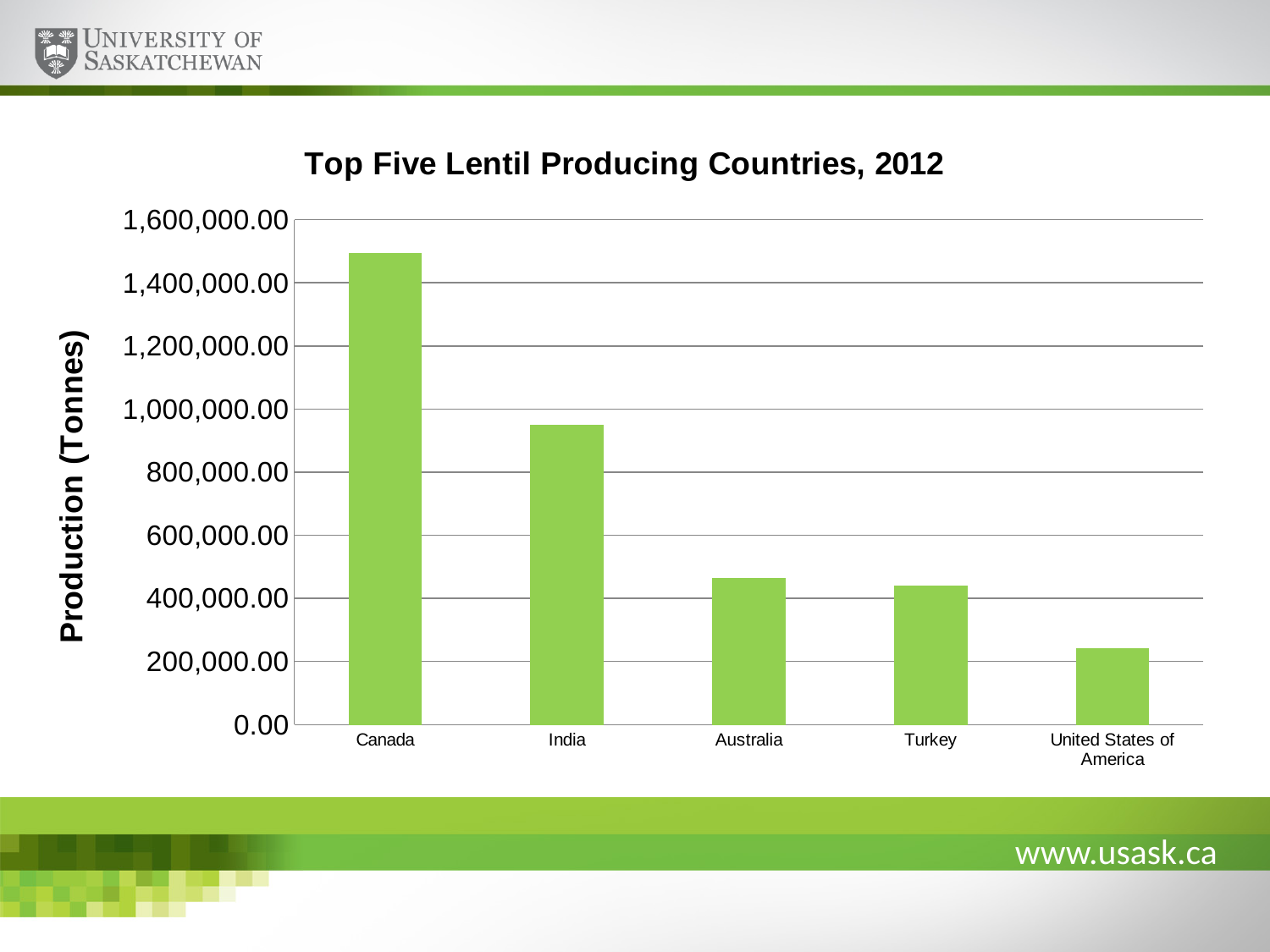
Is the value for United States of America greater or less than 400,000.00? less Is the value for India greater or less than 1,000,000.00? less How many countries are shown in the chart? 5 Which country has the lowest lentil production in the chart? United States of America Which country has the highest lentil production in the chart? Canada Is the value for Canada greater or less than 1,400,000.00? greater What kind of chart is shown on the slide? bar chart Which has the larger value, Turkey or United States of America? Turkey What is the title of the chart? Top Five Lentil Producing Countries, 2012 What is the label of the vertical axis? Production (Tonnes) Which has the larger value, Canada or India? Canada